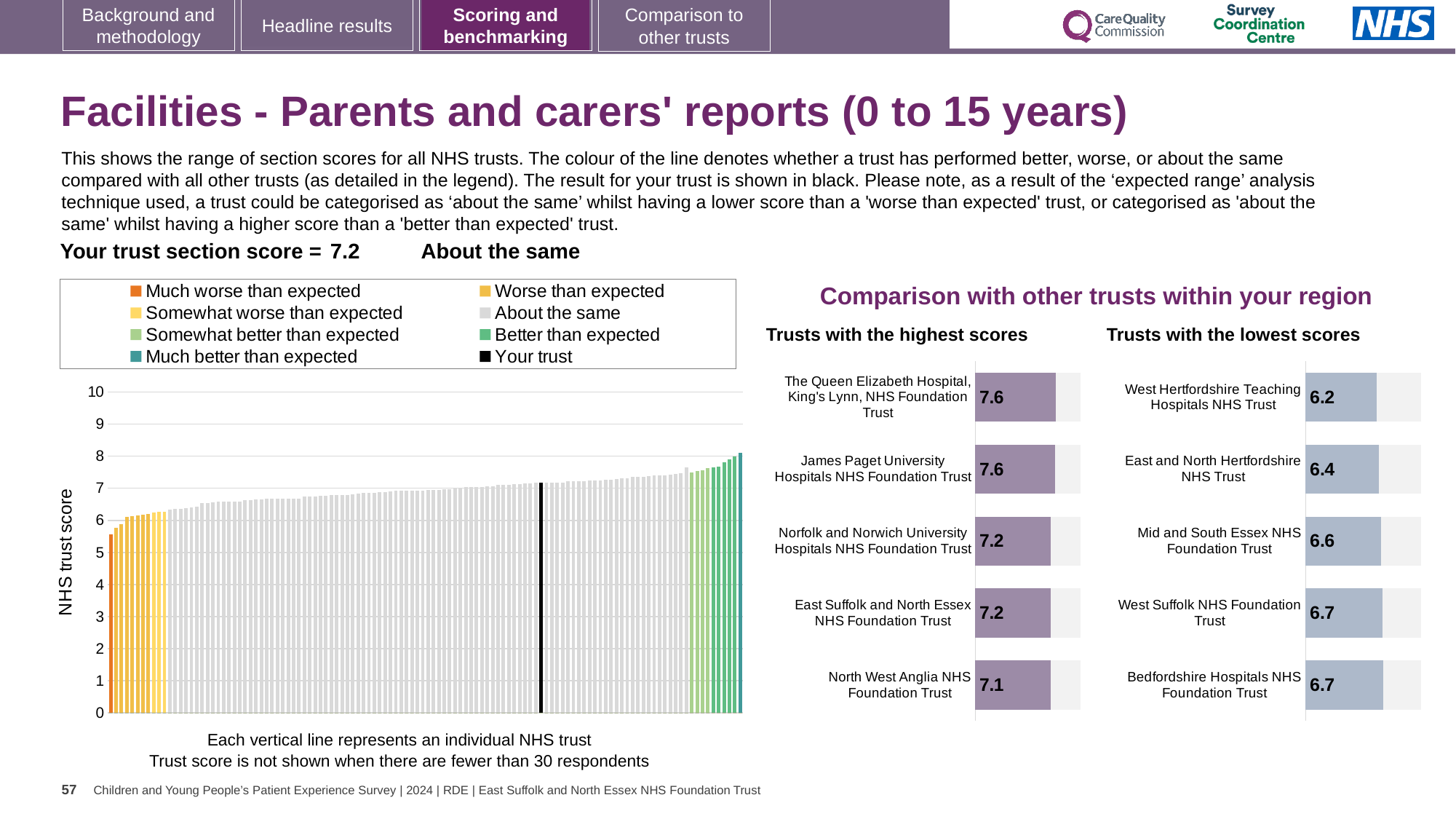
In the 'Trusts with the highest scores' chart, what is the score for The Queen Elizabeth Hospital, King's Lynn, NHS Foundation Trust? 7.6 How many trusts are shown in the 'Trusts with the highest scores' chart? 5 In the 'Trusts with the highest scores' chart, what is the difference between the scores of James Paget University Hospitals NHS Foundation Trust and North West Anglia NHS Foundation Trust? 0.5 In the 'Trusts with the lowest scores' chart, which trust has the lowest score? West Hertfordshire Teaching Hospitals NHS Trust What kind of chart is the main chart showing NHS trust scores for all trusts? bar chart How many entries does the legend of the main NHS trust score chart list? 8 In the main NHS trust score chart, is the value of the black bar (your trust) greater or less than 7? greater In the 'Trusts with the lowest scores' chart, what is the difference between the scores of Bedfordshire Hospitals NHS Foundation Trust and West Hertfordshire Teaching Hospitals NHS Trust? 0.5 What is your trust's section score shown on the slide? 7.2 In the 'Trusts with the lowest scores' chart, which has the higher score: Mid and South Essex NHS Foundation Trust or East and North Hertfordshire NHS Trust? Mid and South Essex NHS Foundation Trust In the 'Trusts with the lowest scores' chart, what is the score for West Hertfordshire Teaching Hospitals NHS Trust? 6.2 In the main NHS trust score chart, do the trust scores rise or fall from left to right? rise